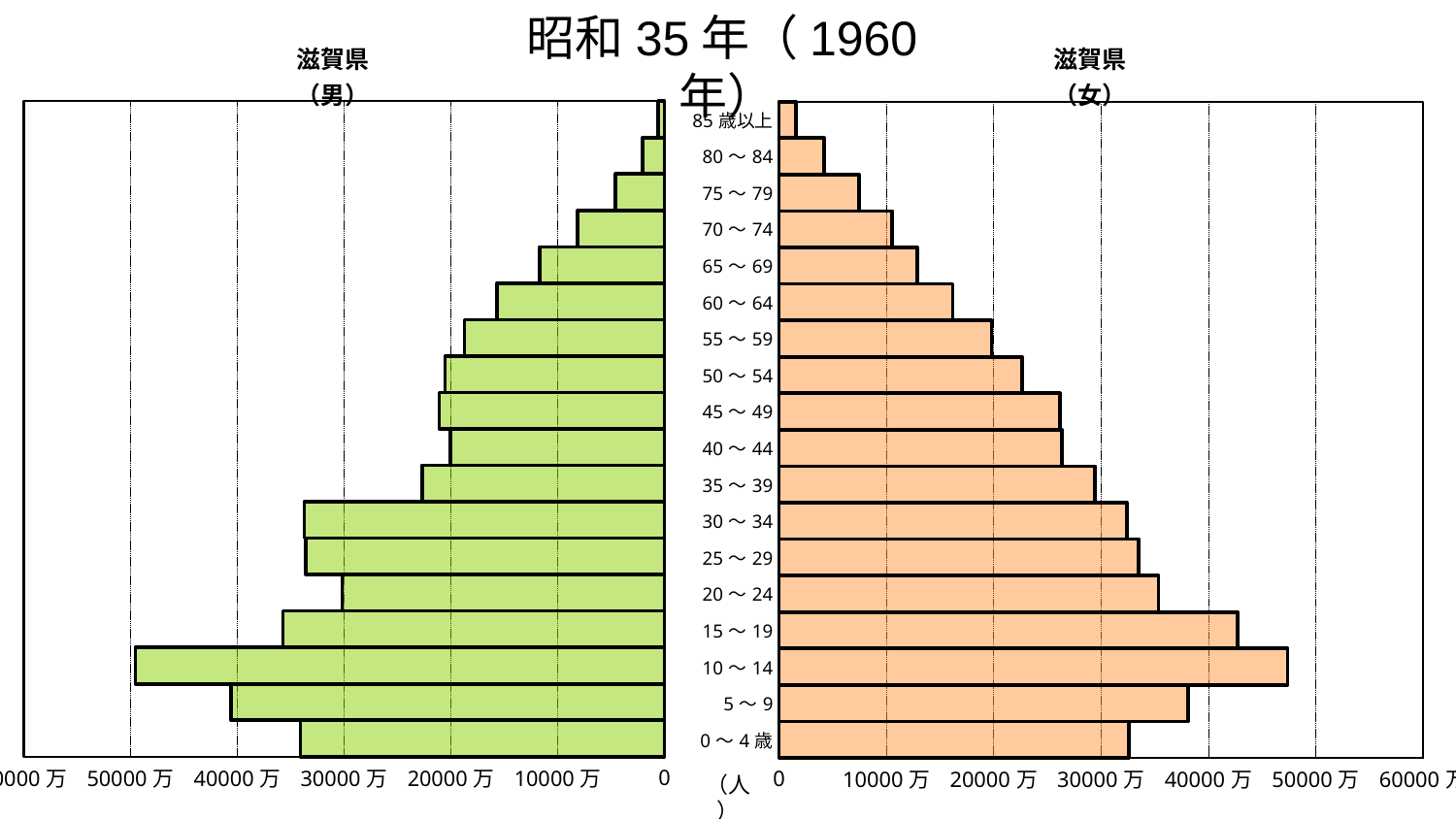
In the 滋賀県（女） chart on the right, which is larger, the value for 15～19 or the value for 20～24? 15～19 How many age categories are plotted in the 滋賀県（女） chart on the right? 18 In the 滋賀県（男） chart on the left, is the value for 60～64 greater or less than 20000万? less In the 滋賀県（男） chart on the left, which age group has the highest value? 10～14 What is the title shown at the top of the slide? 昭和35年（1960年） In the 滋賀県（女） chart on the right, is the value for 0～4歳 greater or less than 30000万? greater What kind of chart is shown on the left side of the slide (滋賀県（男）)? bar chart In the 滋賀県（男） chart on the left, which age group has the lowest value? 85歳以上 In the 滋賀県（男） chart on the left, is the value for 10～14 greater or less than 40000万? greater In the 滋賀県（女） chart on the right, which age group has the lowest value? 85歳以上 In the 滋賀県（男） chart on the left, do the values generally rise or fall as the age groups get older? fall In the 滋賀県（女） chart on the right, which age group has the highest value? 10～14